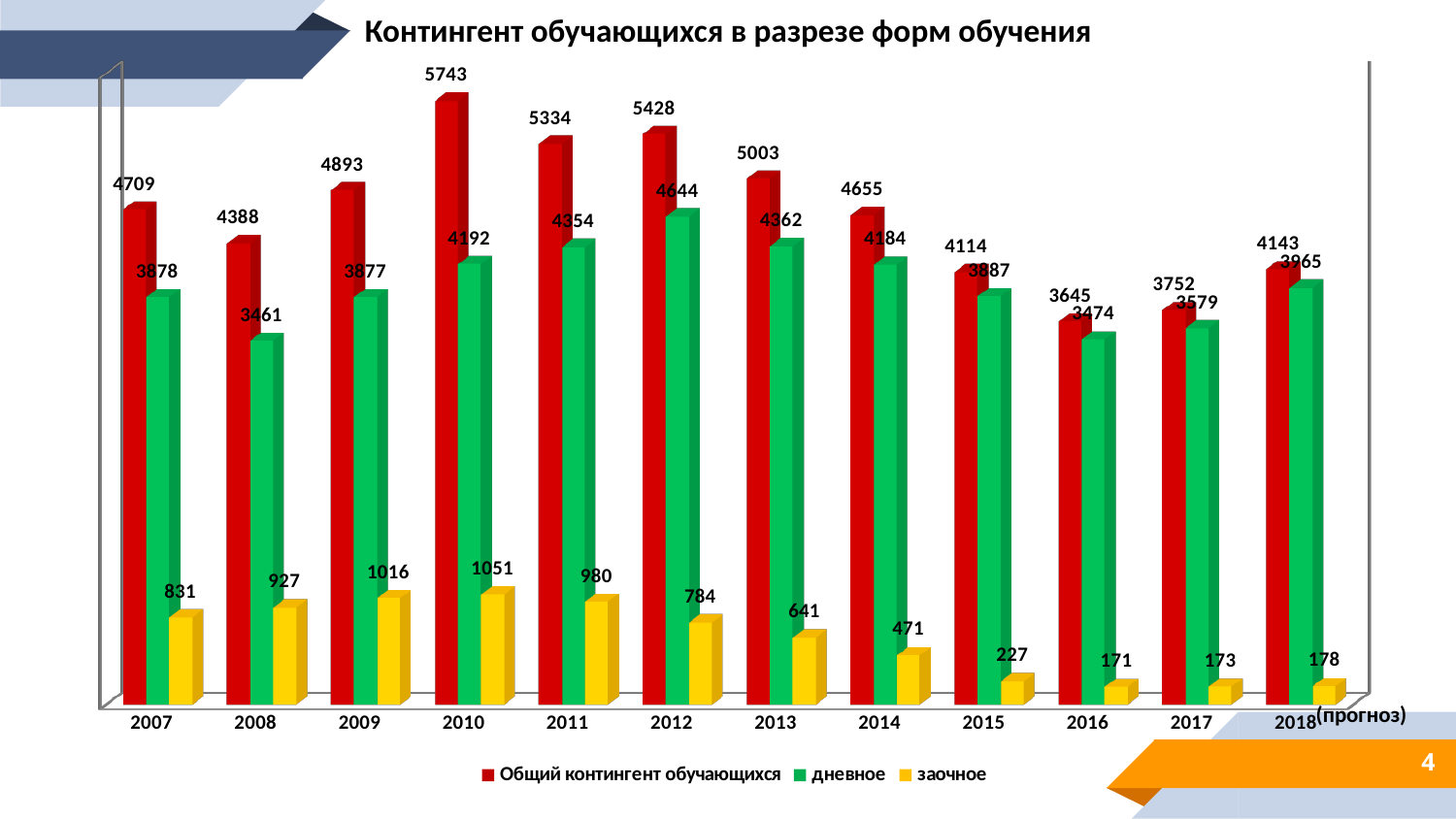
How many series does the legend list? 3 In which year is заочное the lowest? 2016 What is the value of дневное for 2012? 4644 How many years are shown on the x axis? 12 What is the title of the chart? Контингент обучающихся в разрезе форм обучения Does the заочное series rise or fall from 2010 to 2016? Fall Which is larger: заочное in 2009 or заочное in 2011? 2009 In which year is Общий контингент обучающихся the highest? 2010 What is the value of Общий контингент обучающихся for 2010? 5743 What is the difference between Общий контингент обучающихся and дневное in 2007? 831 What is the value of заочное for 2015? 227 What kind of chart is shown on the slide? Bar chart